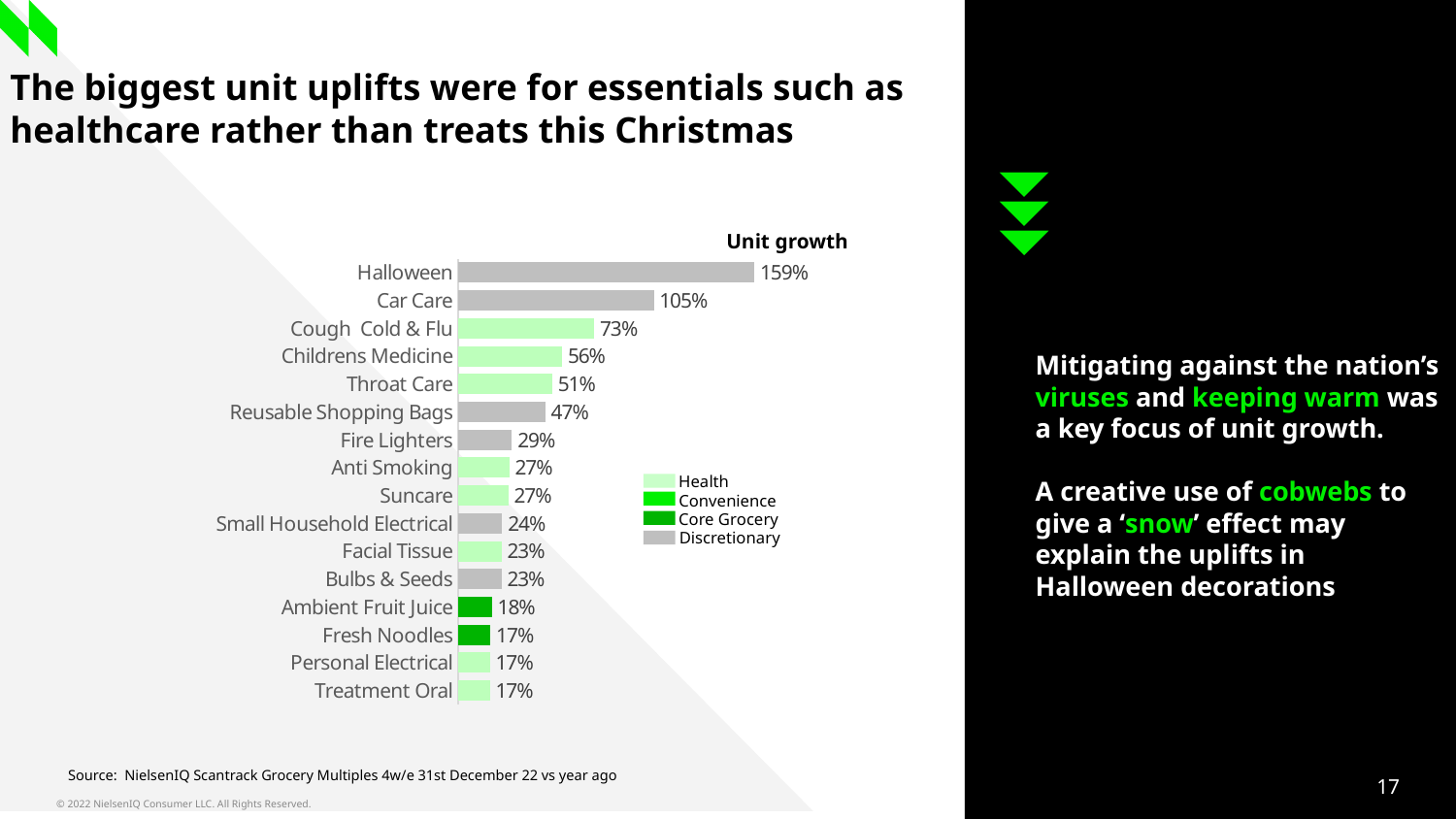
Which has higher unit growth, Fire Lighters or Small Household Electrical? Fire Lighters What is the unit growth for Halloween? 159% How many series does the legend list? 4 What kind of chart is shown on the slide? Bar chart What is the unit growth for Fresh Noodles? 17% What is the difference in unit growth between Childrens Medicine and Throat Care? 5% What is the title of the chart? Unit growth How many categories are shown in the chart? 16 Which category has the highest unit growth? Halloween What is the unit growth for Reusable Shopping Bags? 47% What is the difference in unit growth between Halloween and Car Care? 54% What is the unit growth for Cough Cold & Flu? 73%